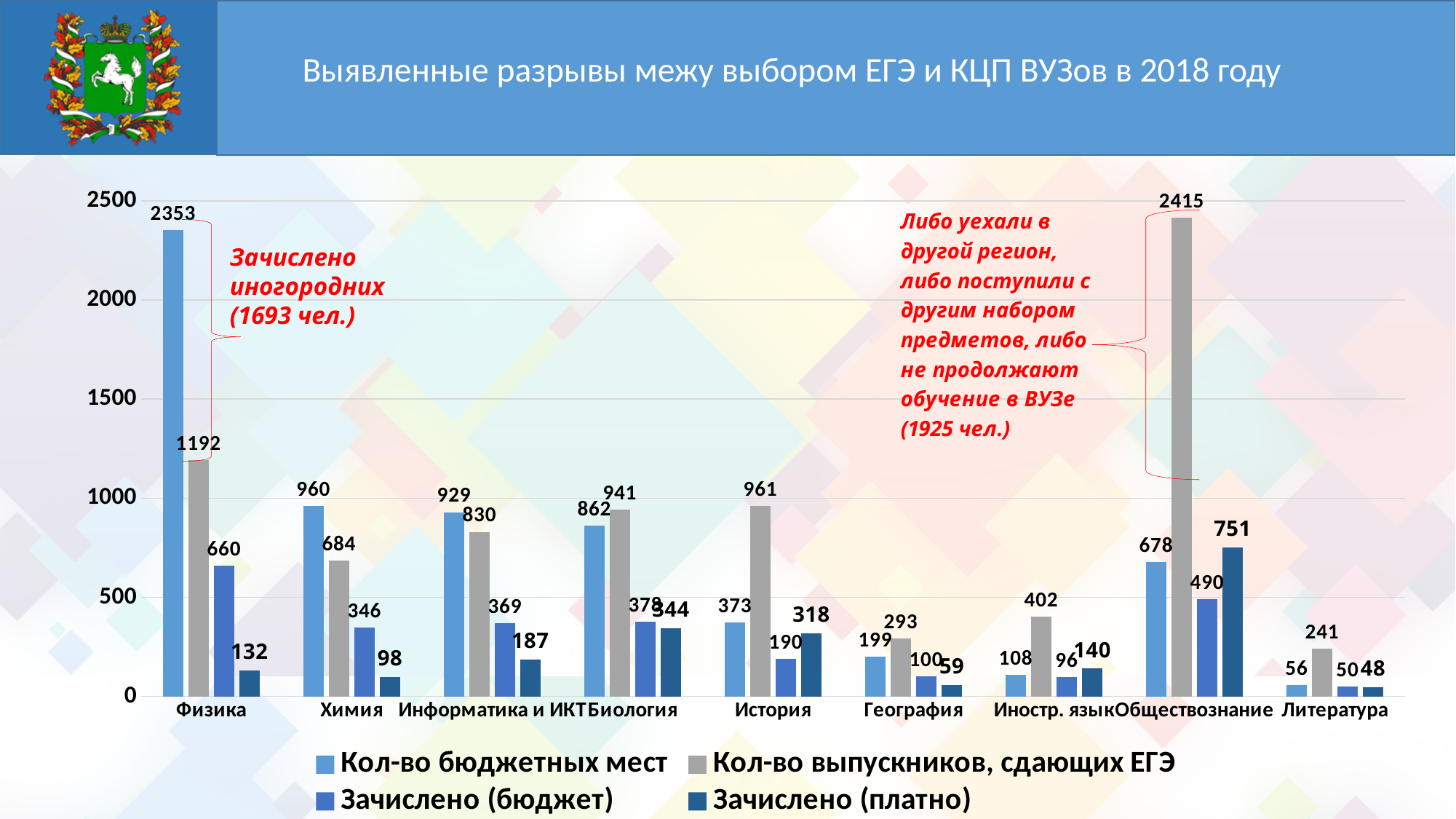
How many subject categories are shown on the x axis? 9 What type of chart is shown on the slide? bar chart For История, which is larger: "Кол-во бюджетных мест" or "Кол-во выпускников, сдающих ЕГЭ"? Кол-во выпускников, сдающих ЕГЭ How many series does the legend list? 4 What is the value of "Зачислено (платно)" for Биология? 344 Which subject has the highest value for "Кол-во выпускников, сдающих ЕГЭ"? Обществознание What is the title of the chart on the slide? Выявленные разрывы межу выбором ЕГЭ и КЦП ВУЗов в 2018 году What is the value of "Зачислено (бюджет)" for Химия? 346 What is the difference between "Кол-во бюджетных мест" and "Кол-во выпускников, сдающих ЕГЭ" for Физика? 1161 Which subject has the lowest value for "Кол-во бюджетных мест"? Литература What is the value of "Кол-во выпускников, сдающих ЕГЭ" for Обществознание? 2415 What is the value of "Кол-во бюджетных мест" for Физика? 2353